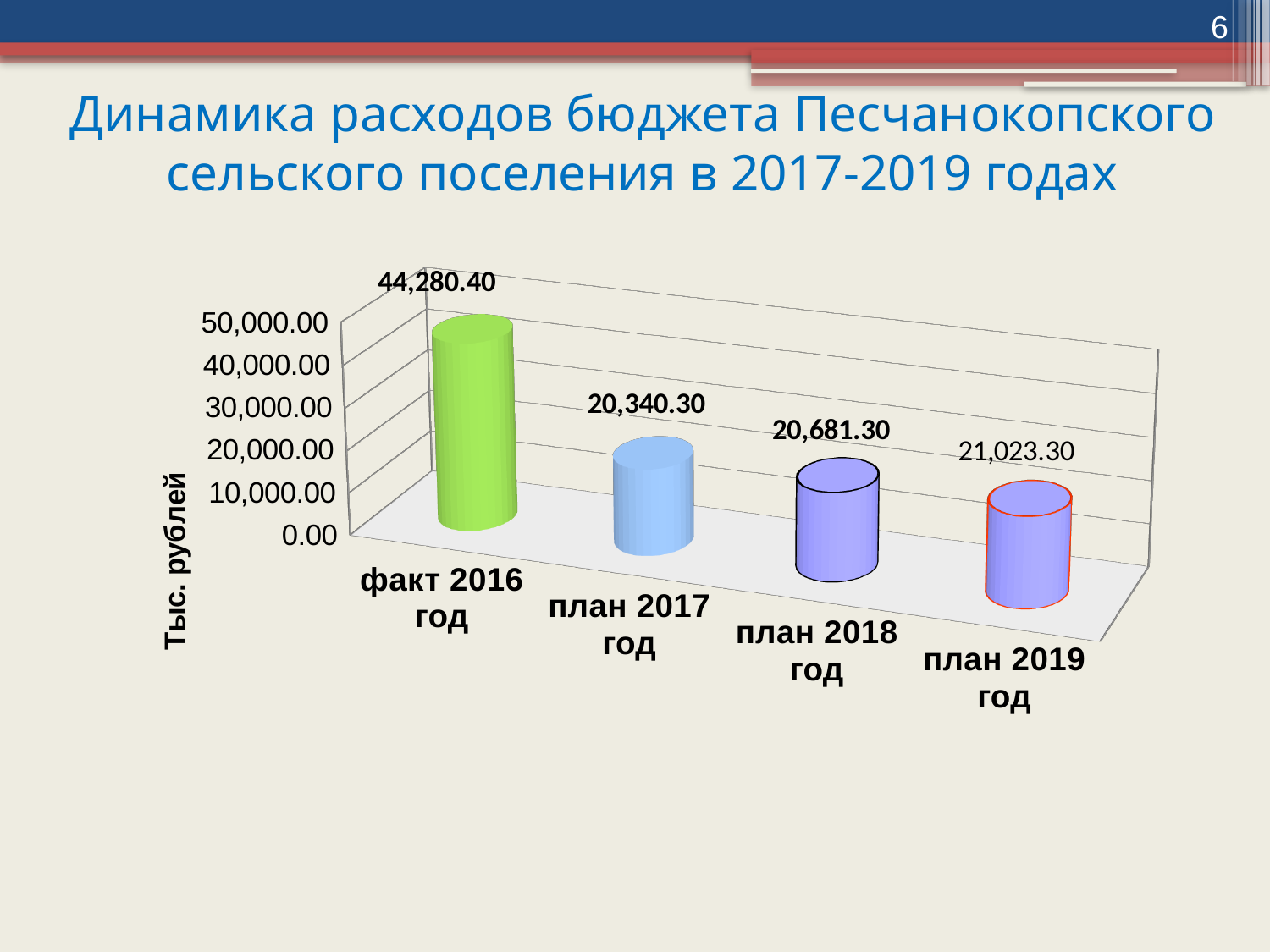
Which category has the lowest value? план 2017 год What is the value for факт 2016 год? 44,280.40 What is the label of the vertical axis? Тыс. рублей What is the difference between the values for факт 2016 год and план 2017 год? 23,940.10 What is the difference between the values for план 2019 год and план 2018 год? 342.00 What is the value for план 2018 год? 20,681.30 What is the value for план 2019 год? 21,023.30 Which is larger, the value for план 2018 год or the value for план 2017 год? план 2018 год What kind of chart is shown on the slide? bar chart Which category has the highest value? факт 2016 год How many categories are shown on the chart? 4 What is the value for план 2017 год? 20,340.30